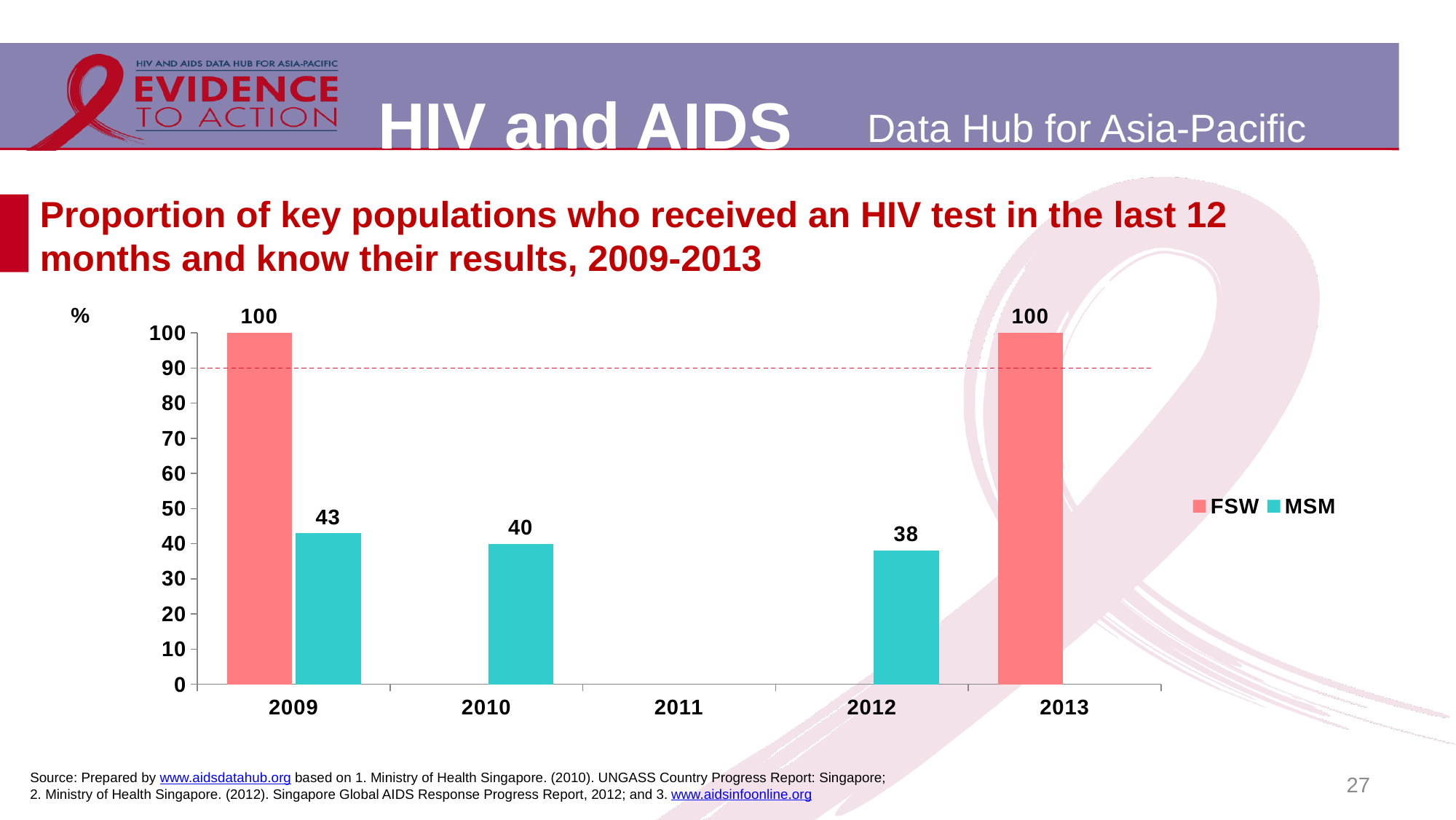
In which year is the MSM value highest? 2009 What is the value for FSW in 2013? 100 Do the MSM values rise or fall from 2009 to 2012? Fall What is the difference between the FSW and MSM values in 2009? 57 What is the value for FSW in 2009? 100 What is the value for MSM in 2010? 40 What is the value for MSM in 2012? 38 What kind of chart is shown on the slide? Bar chart How many years are shown on the x axis? 5 How many series does the legend list? 2 Which is larger, the MSM value in 2010 or the MSM value in 2012? MSM in 2010 In which year is the MSM value lowest? 2012